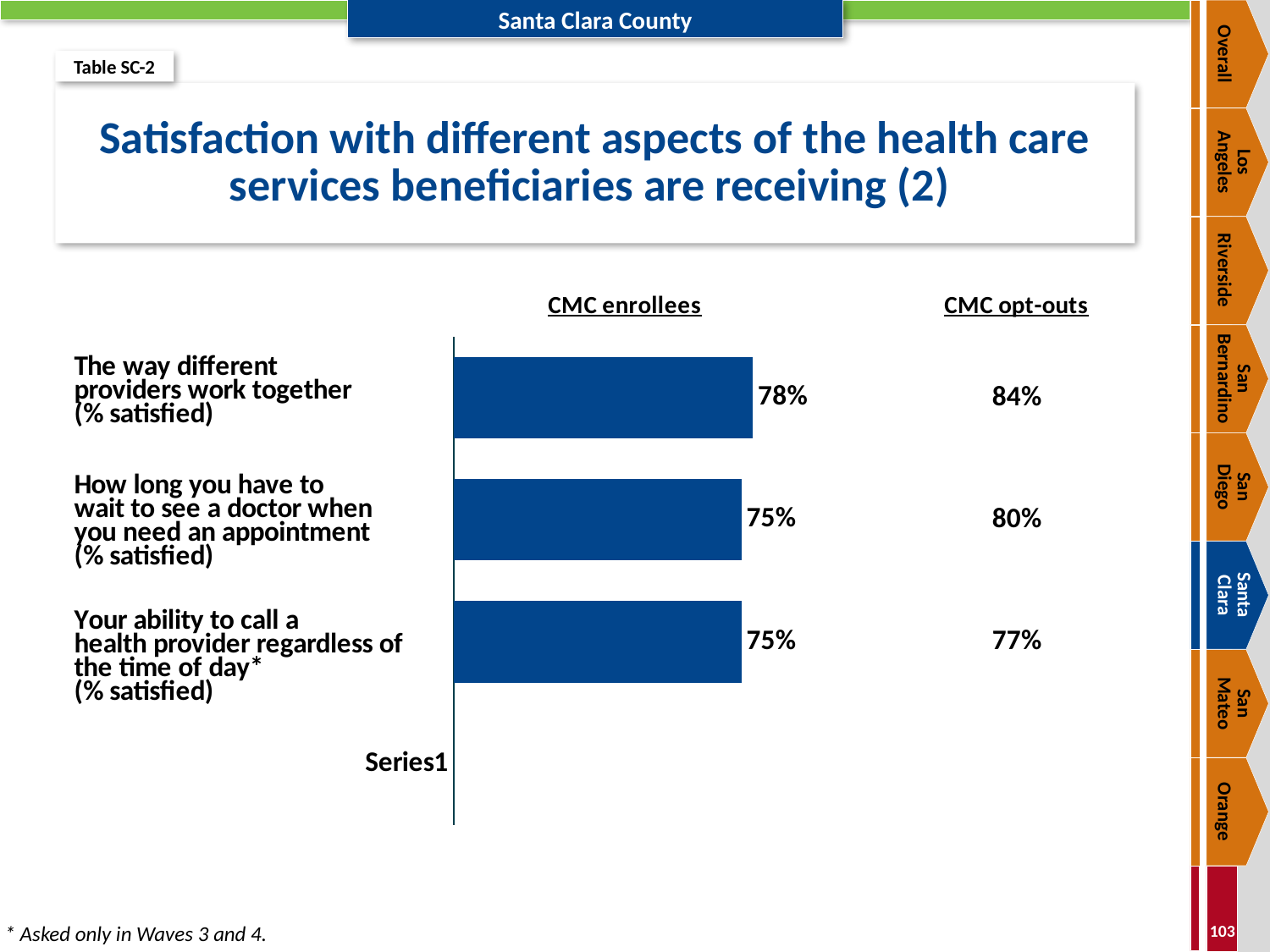
What is the difference between the CMC opt-outs and CMC enrollees values for "How long you have to wait to see a doctor when you need an appointment"? 5 percentage points What is the CMC enrollees value for "The way different providers work together"? 78% What kind of chart is shown on the slide? Bar chart How many aspects of health care services are shown on the chart? 3 Which aspect has the lowest CMC opt-outs satisfaction? Your ability to call a health provider regardless of the time of day What is the difference between the CMC opt-outs and CMC enrollees values for "The way different providers work together"? 6 percentage points What is the CMC opt-outs value for "Your ability to call a health provider regardless of the time of day"? 77% Which aspect has the highest CMC enrollees satisfaction? The way different providers work together What is the CMC enrollees value for "How long you have to wait to see a doctor when you need an appointment"? 75% For "Your ability to call a health provider regardless of the time of day", which group has the higher satisfaction, CMC enrollees or CMC opt-outs? CMC opt-outs What is the CMC opt-outs value for "The way different providers work together"? 84% What is the title of the chart on the slide? Satisfaction with different aspects of the health care services beneficiaries are receiving (2)